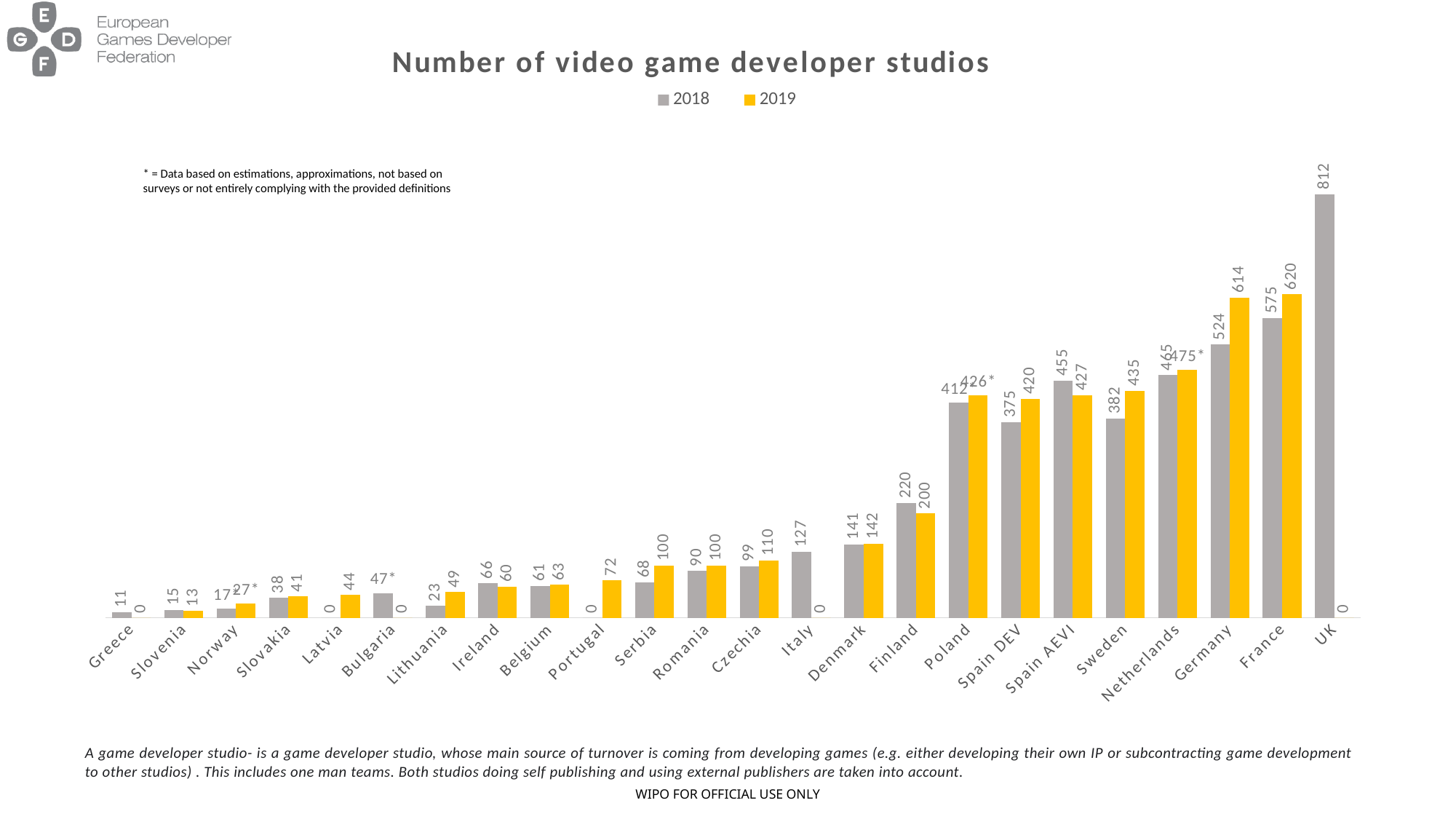
What is the 2018 value for France? 575 What is the difference between Finland's 2018 and 2019 values? 20 Which country has the highest 2019 value? France What kind of chart is shown on the slide? Bar chart How many series does the legend list? 2 What is the number of video game developer studios in the UK in 2018? 812 What is the 2019 value for Germany? 614 What is the difference between Germany's 2019 and 2018 values? 90 For Spain AEVI, which year has the larger value, 2018 or 2019? 2018 What is the 2019 value for Finland? 200 Which country has the highest 2018 value? UK How many countries/categories are shown on the x axis? 24